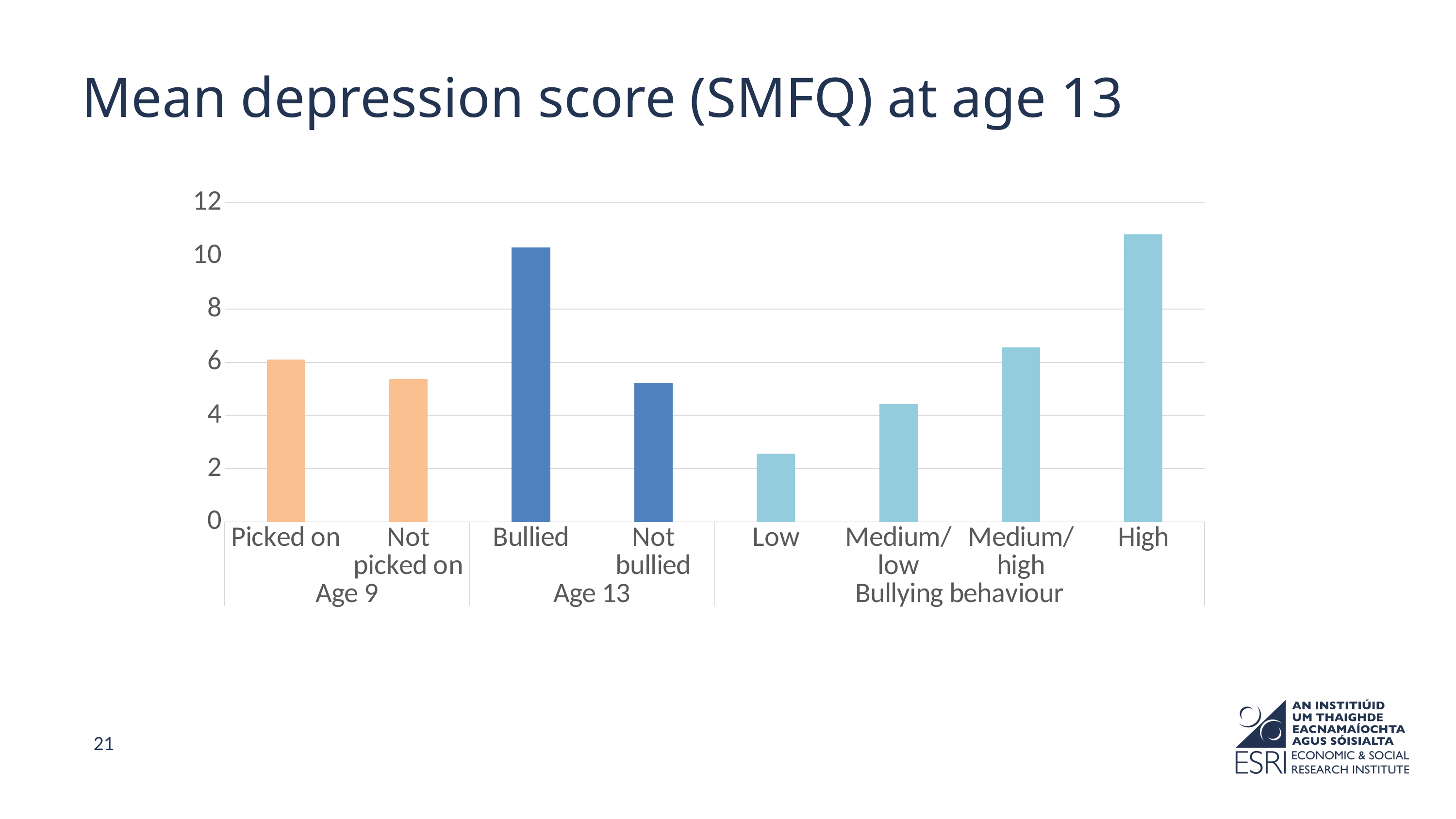
Is the mean depression score for Bullied at age 13 greater or less than 8? greater Is the mean depression score for Low bullying behaviour greater or less than 4? less What kind of chart is shown on the slide? bar chart What is the title of the chart? Mean depression score (SMFQ) at age 13 Is the mean depression score for Medium/low bullying behaviour greater or less than 6? less Which category has the lowest mean depression score? Low Which category has the highest mean depression score? High Which has a higher mean depression score: Picked on or Not picked on at age 9? Picked on Which has a higher mean depression score: Bullied or Not bullied at age 13? Bullied How many bars are plotted in the chart? 8 Across the Bullying behaviour categories from Low to High, do the mean depression scores rise or fall? rise